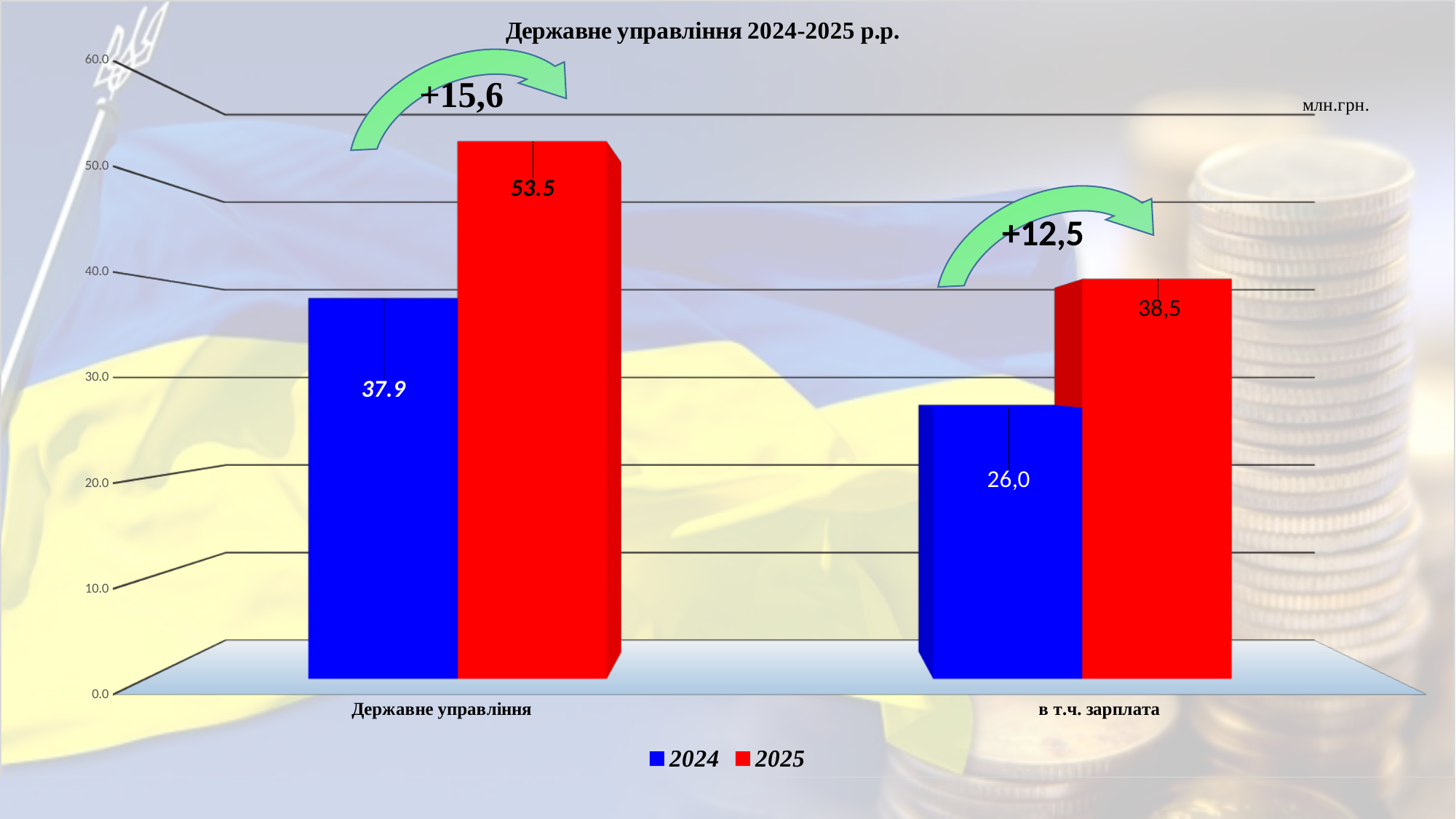
Which bar has the lowest value on the chart? 2024, в т.ч. зарплата By how much does the 2025 value exceed the 2024 value for "в т.ч. зарплата"? 12,5 By how much does the 2025 value exceed the 2024 value for "Державне управління"? 15,6 How many categories are shown on the x axis? 2 Which bar has the highest value on the chart? 2025, Державне управління How many series does the legend list? 2 What is the value for 2024 in the category "в т.ч. зарплата"? 26,0 What is the value for 2025 in the category "Державне управління"? 53.5 What is the value for 2024 in the category "Державне управління"? 37.9 What type of chart is shown on the slide? Bar chart What is the value for 2025 in the category "в т.ч. зарплата"? 38,5 Which is larger for "в т.ч. зарплата": the 2024 value or the 2025 value? 2025